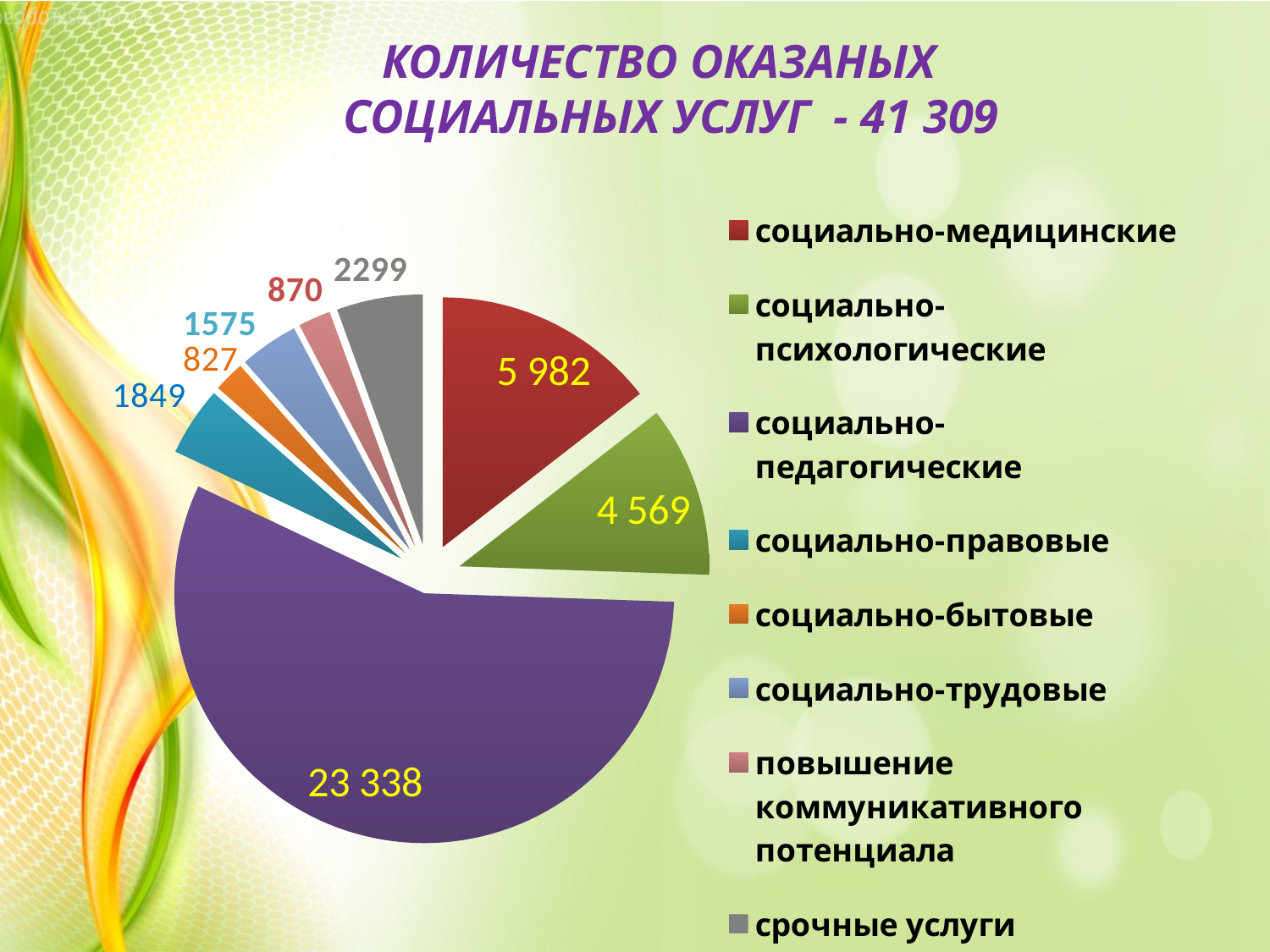
What is the difference between the values for социально-медицинские and социально-психологические services? 1 413 What type of chart is shown on the slide? pie chart What is the value for срочные услуги? 2299 What is the value for социально-педагогические services? 23 338 What total number of social services is stated in the chart title? 41 309 Which is larger: the value for социально-правовые or for социально-трудовые services? социально-правовые What is the value for социально-бытовые services? 827 Which category has the smallest slice of the pie? социально-бытовые How many slices does the pie chart have? 8 Which category has the largest slice of the pie? социально-педагогические What is the value for социально-психологические services? 4 569 What is the value for социально-медицинские services? 5 982